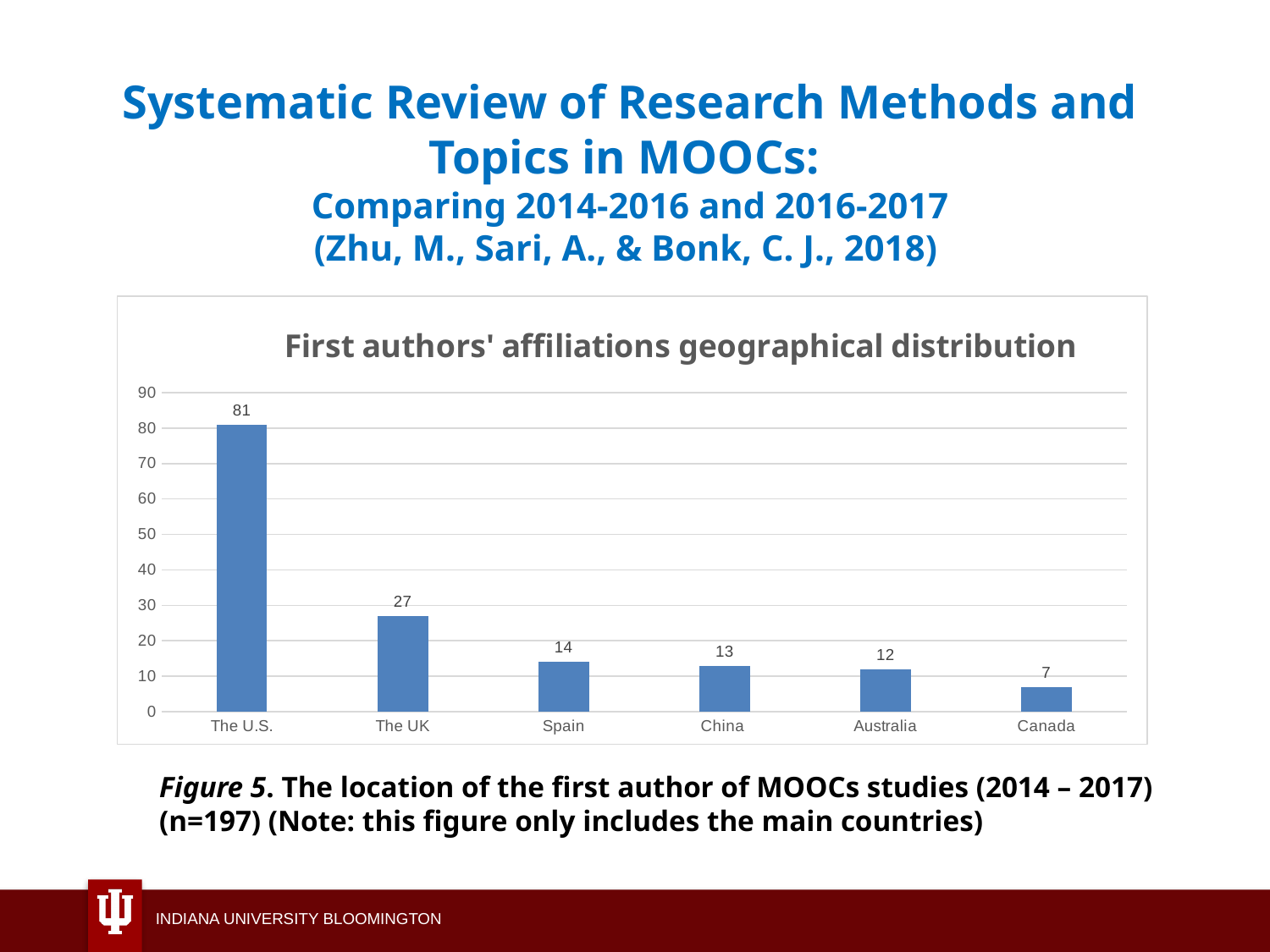
How many countries are shown on the x axis? 6 What is the value for Spain? 14 Is the value for The UK greater or less than 30? less What is the title of the chart? First authors' affiliations geographical distribution What is the difference between the values for The U.S. and The UK? 54 What is the difference between the values for China and Australia? 1 Which is larger, the value for The UK or the value for Spain? The UK Which country has the lowest value? Canada Which country has the highest value? The U.S. What is the value for Canada? 7 What is the value for The U.S.? 81 What kind of chart is shown? bar chart